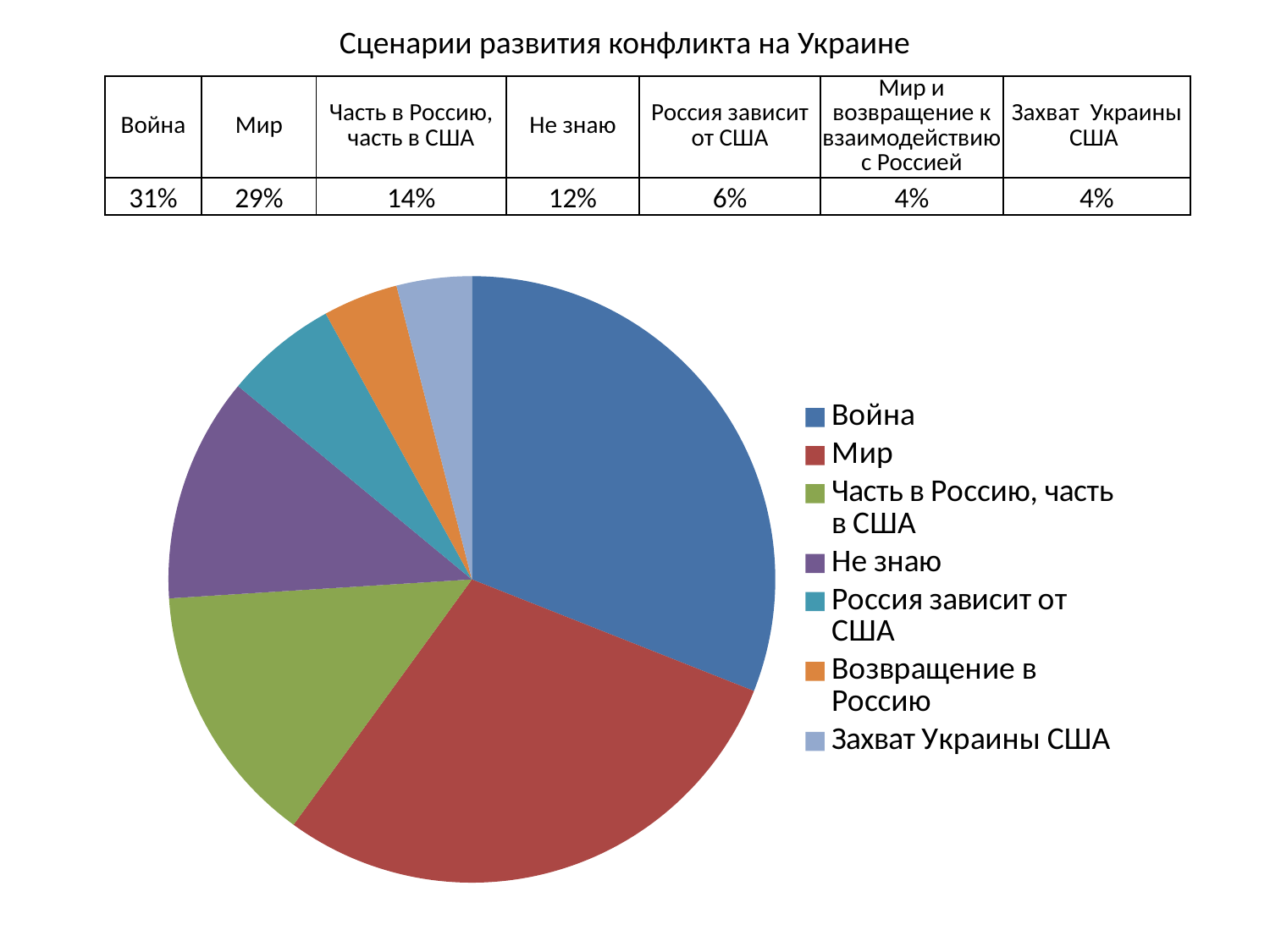
What is the value for Война? 31% What is the difference between the values for Война and Мир? 2% What share of the pie does Захват Украины США take? 4% Which is larger, Часть в Россию, часть в США or Не знаю? Часть в Россию, часть в США How many slices does the pie chart have? 7 What is the value for Россия зависит от США? 6% What is the value for Мир? 29% What is the value for Не знаю? 12% Which category has the largest slice of the pie? Война What is the title of the slide? Сценарии развития конфликта на Украине How many entries does the legend of the pie chart list? 7 What kind of chart is shown on the slide? pie chart